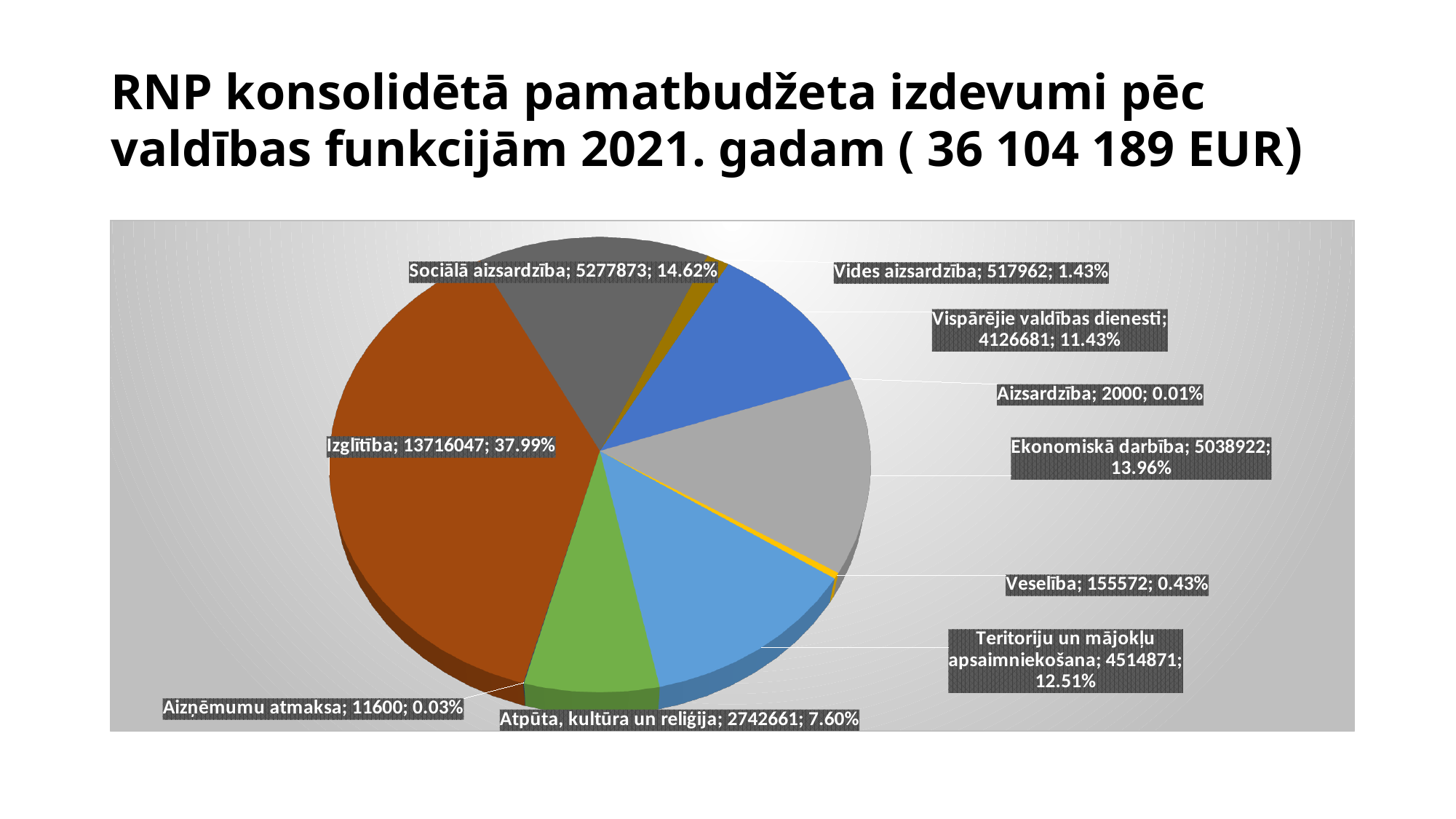
What is the value for Veselība? 155572 What is the value for Teritoriju un mājokļu apsaimniekošana? 4514871 Which category has the largest slice? Izglītība What is the value for Izglītība? 13716047 Which category has the smallest slice? Aizsardzība What share of the pie does Sociālā aizsardzība represent? 14.62% Which is larger, Vispārējie valdības dienesti or Atpūta, kultūra un reliģija? Vispārējie valdības dienesti What percentage is shown for Ekonomiskā darbība? 13.96% What total amount in EUR is stated in the chart title? 36 104 189 EUR What kind of chart is shown on the slide? pie chart What is the difference between the values for Sociālā aizsardzība and Ekonomiskā darbība? 238951 How many slices does the pie chart have? 10